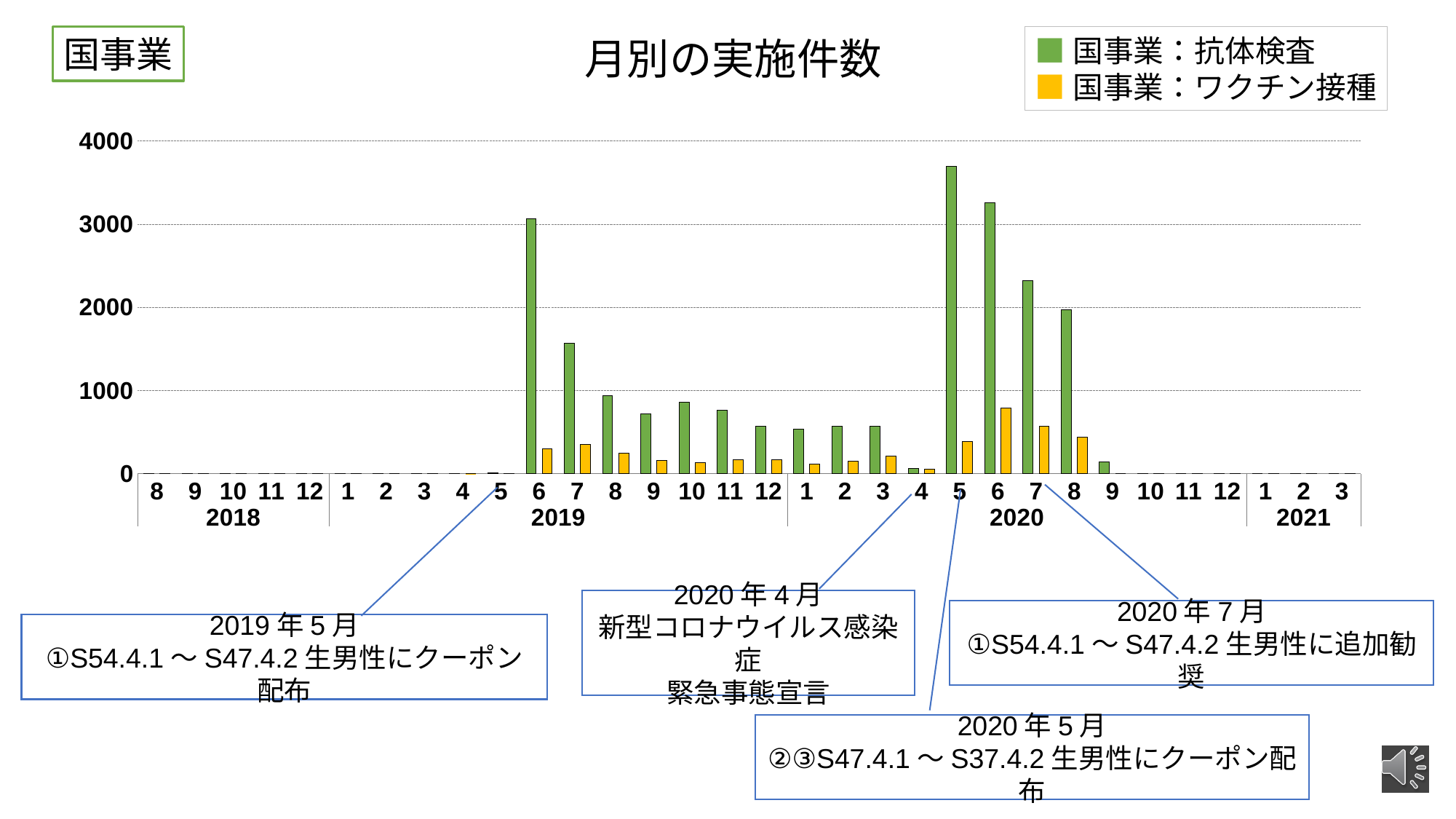
Is the 国事業：抗体検査 value for 2020年7月 greater or less than 2000? greater What is the title of the chart? 月別の実施件数 Is the 国事業：抗体検査 value for 2020年9月 greater or less than 1000? less Is the 国事業：抗体検査 value for 2020年5月 greater or less than 3000? greater In which month is the 国事業：ワクチン接種 value highest? 2020年6月 Which series is shown in yellow according to the legend? 国事業：ワクチン接種 How many series does the legend list? 2 In which month is the 国事業：抗体検査 value highest? 2020年5月 Which is larger, the 国事業：抗体検査 value for 2019年6月 or for 2020年5月? 2020年5月 What kind of chart is shown on the slide? bar chart From 2020年5月 to 2020年9月, do the 国事業：抗体検査 values rise or fall? fall